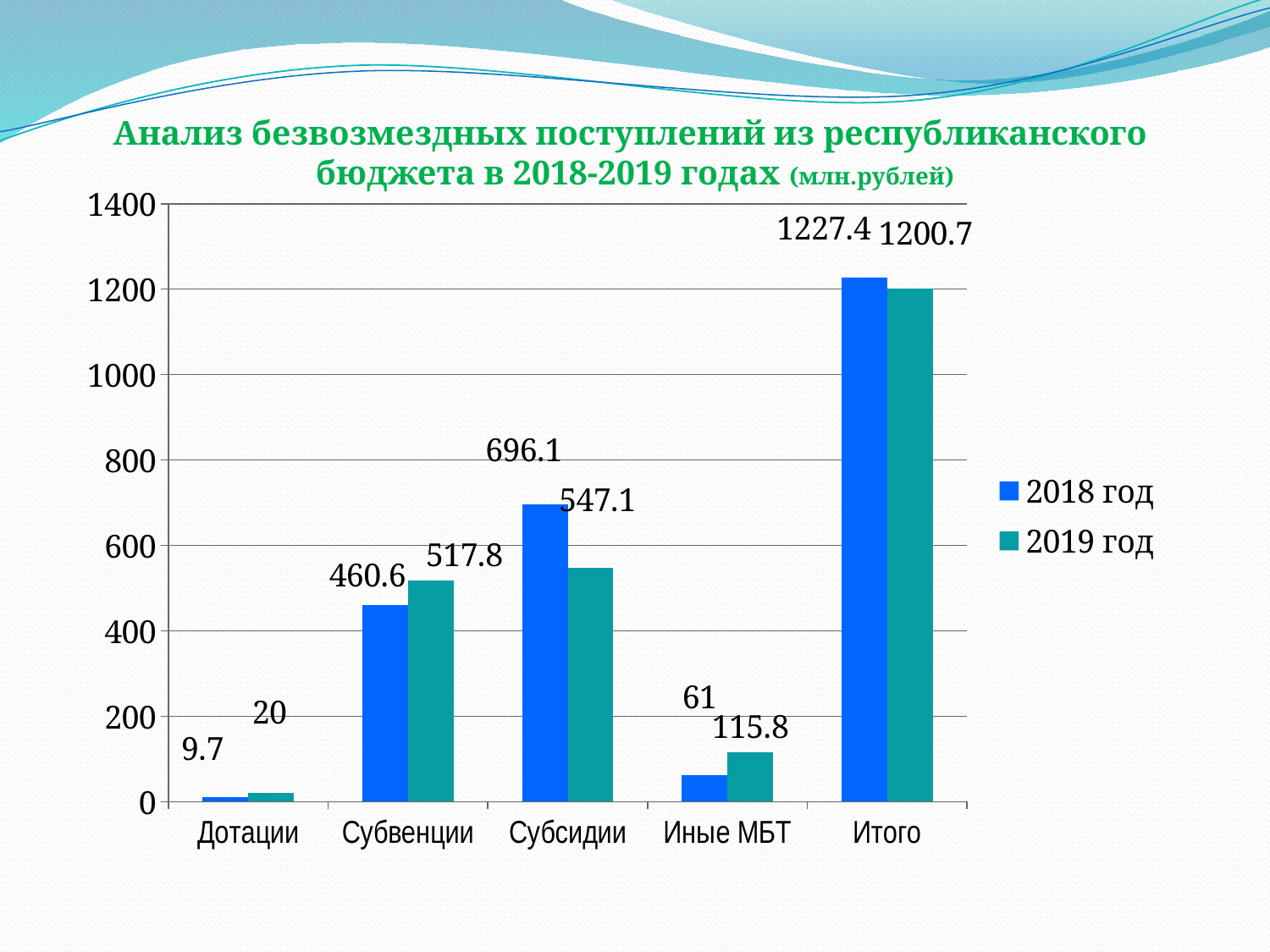
What is the value for Дотации in the 2018 год series? 9.7 What kind of chart is shown on the slide? bar chart What is the value for Субсидии in the 2018 год series? 696.1 Which category has the lowest value in the 2019 год series? Дотации Is the value for Иные МБТ in the 2019 год series greater or less than 200? less Which is larger for Субвенции: the 2018 год value or the 2019 год value? 2019 год What is the value for Субвенции in the 2019 год series? 517.8 What is the value for Иные МБТ in the 2019 год series? 115.8 How many series does the legend list? 2 How many categories are shown on the x axis? 5 What is the difference between the 2018 год and 2019 год values for Субсидии? 149 Excluding Итого, which category has the highest value in the 2018 год series? Субсидии